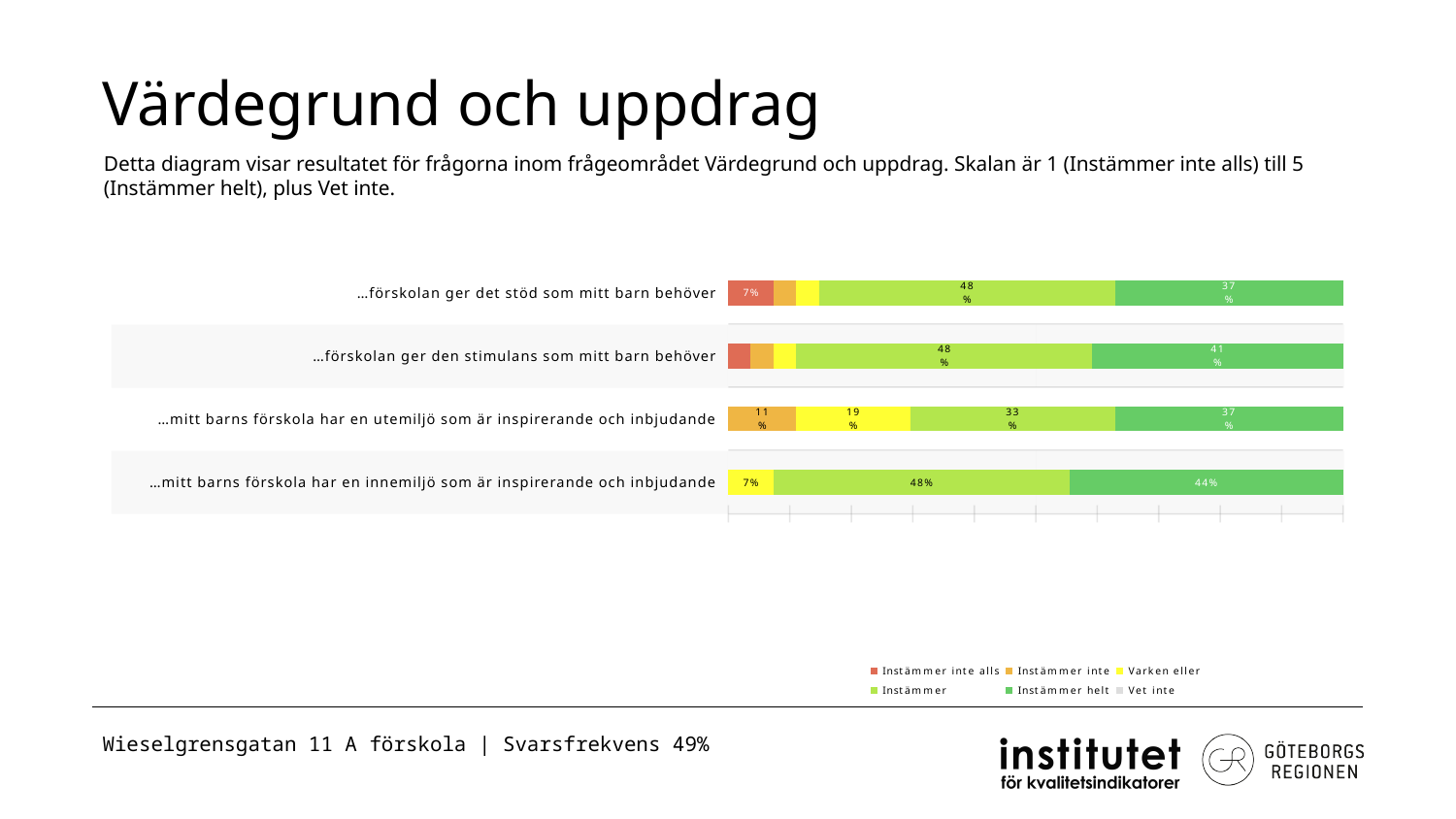
Which has the larger 'Instämmer helt' value: the utemiljö statement or the innemiljö statement? The innemiljö statement What is the 'Instämmer helt' value for '…mitt barns förskola har en innemiljö som är inspirerande och inbjudande'? 44% How many statements (categories) are plotted in the chart? 4 What is the 'Instämmer' value for '…mitt barns förskola har en utemiljö som är inspirerande och inbjudande'? 33% What is the title of the slide containing the chart? Värdegrund och uppdrag What kind of chart is shown on the slide? Stacked bar chart Which statement has the lowest 'Instämmer' value? …mitt barns förskola har en utemiljö som är inspirerande och inbjudande Which statement has the highest 'Instämmer helt' value? …mitt barns förskola har en innemiljö som är inspirerande och inbjudande What is the 'Instämmer helt' value for '…förskolan ger den stimulans som mitt barn behöver'? 41% How many series does the chart legend list? 6 What is the difference in 'Instämmer helt' between '…förskolan ger den stimulans som mitt barn behöver' and '…förskolan ger det stöd som mitt barn behöver'? 4 percentage points What is the 'Varken eller' value for '…mitt barns förskola har en utemiljö som är inspirerande och inbjudande'? 19%